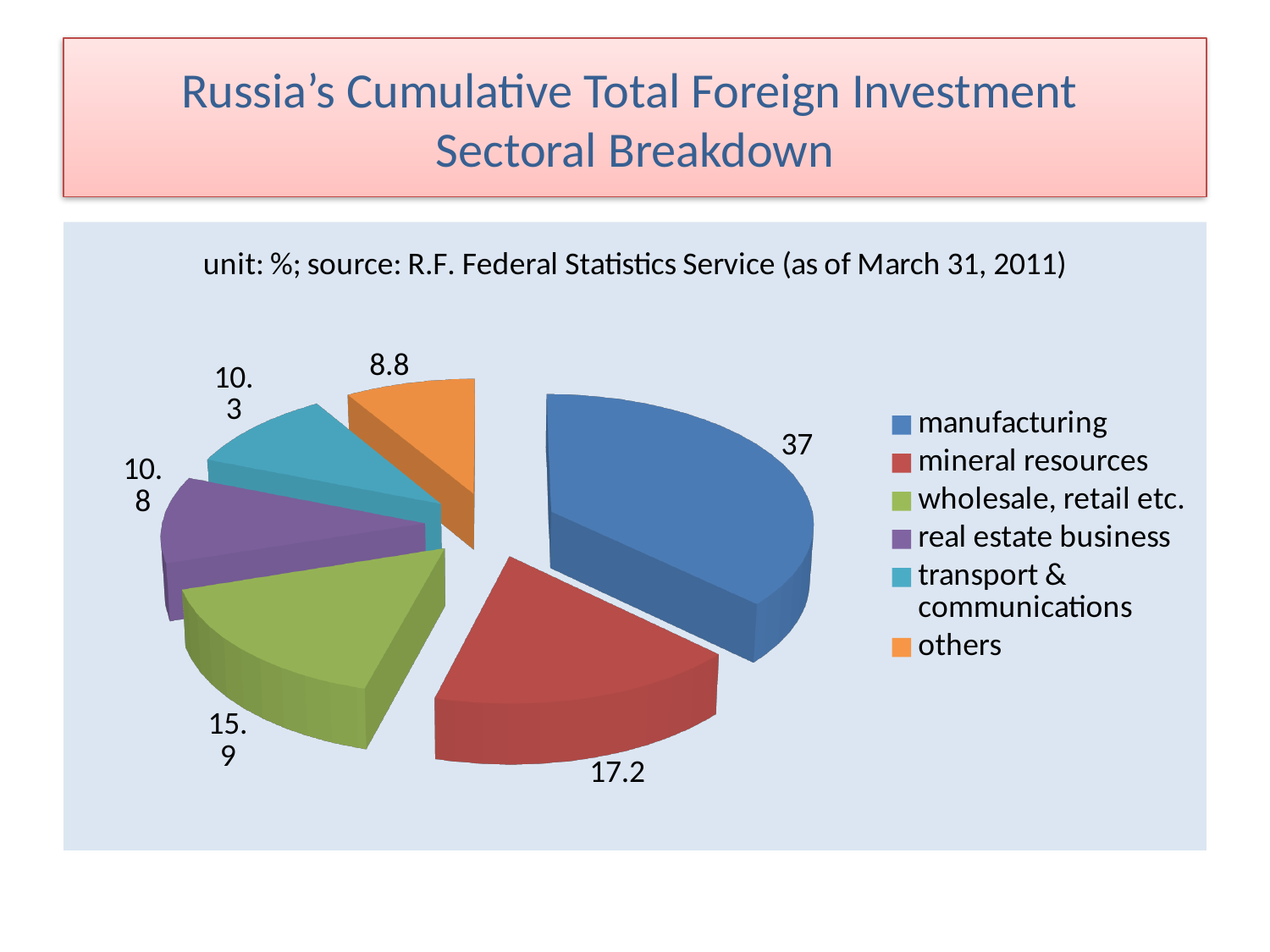
What is the value shown for real estate business? 10.8 What unit is stated for the values in the chart? % Which sector has the largest share of the pie? manufacturing What is the value shown for wholesale, retail etc.? 15.9 What is the value shown for manufacturing? 37 Which sector has the smallest share of the pie? others How many sectors does the legend list? 6 Which is larger, the value for wholesale, retail etc. or the value for real estate business? wholesale, retail etc. What is the value shown for mineral resources? 17.2 What kind of chart is shown on the slide? pie chart What is the value shown for others? 8.8 What is the difference between the values for manufacturing and mineral resources? 19.8